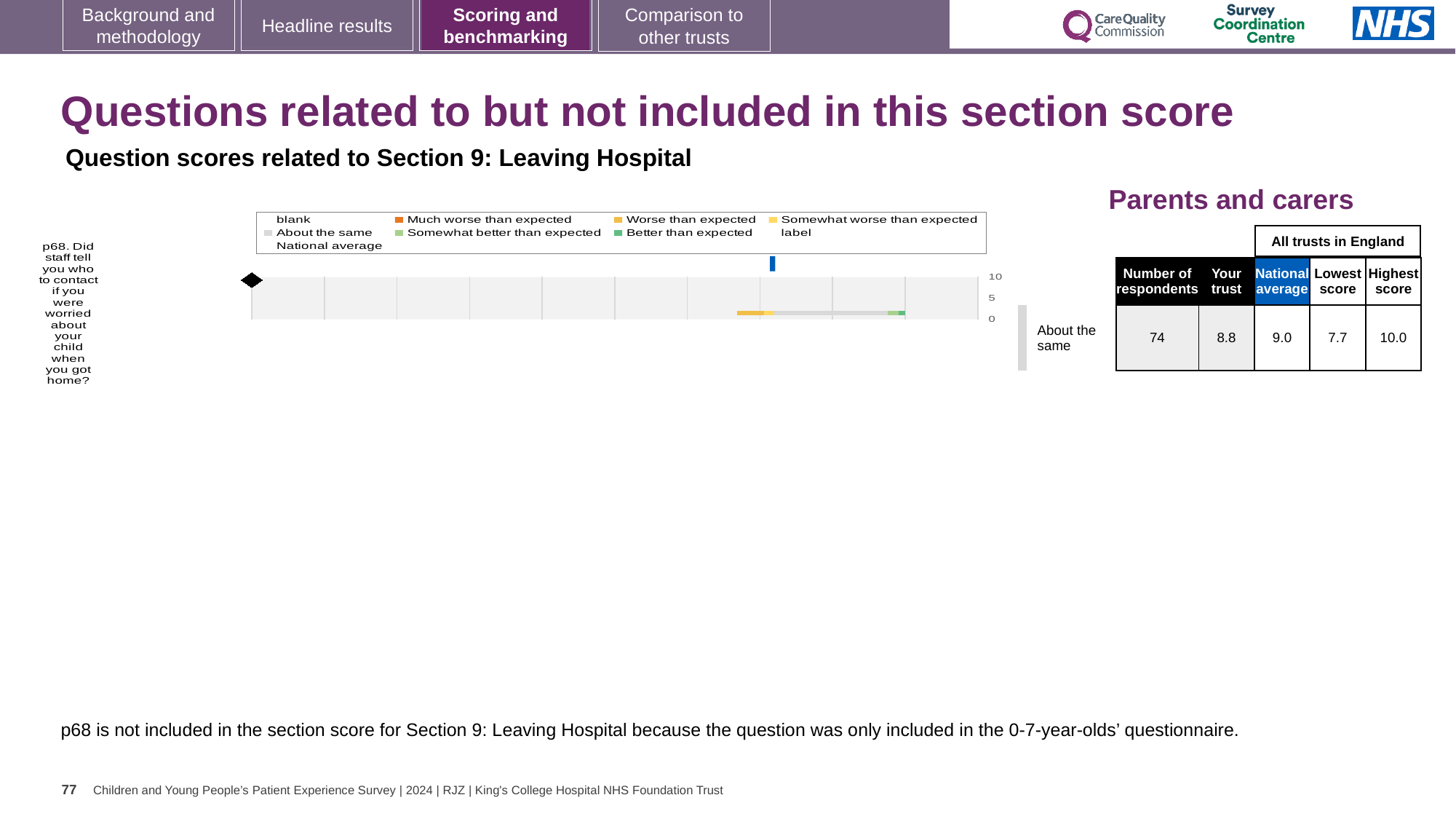
Which is larger for p68, the 'Your trust' score or the national average? National average What is the national average score for p68? 9.0 What kind of chart is shown for the p68 question score? bar chart How many respondents answered p68? 74 What is the difference between the highest score and the lowest score for p68? 2.3 What is the difference between the national average and the 'Your trust' score for p68? 0.2 What is the highest score among all trusts in England for p68? 10.0 What benchmark category is the trust's p68 score placed in? About the same What is the 'Your trust' score for p68? 8.8 Which question is plotted in the chart? p68. Did staff tell you who to contact if you were worried about your child when you got home? How many questions are plotted in the chart? 1 What is the lowest score among all trusts in England for p68? 7.7